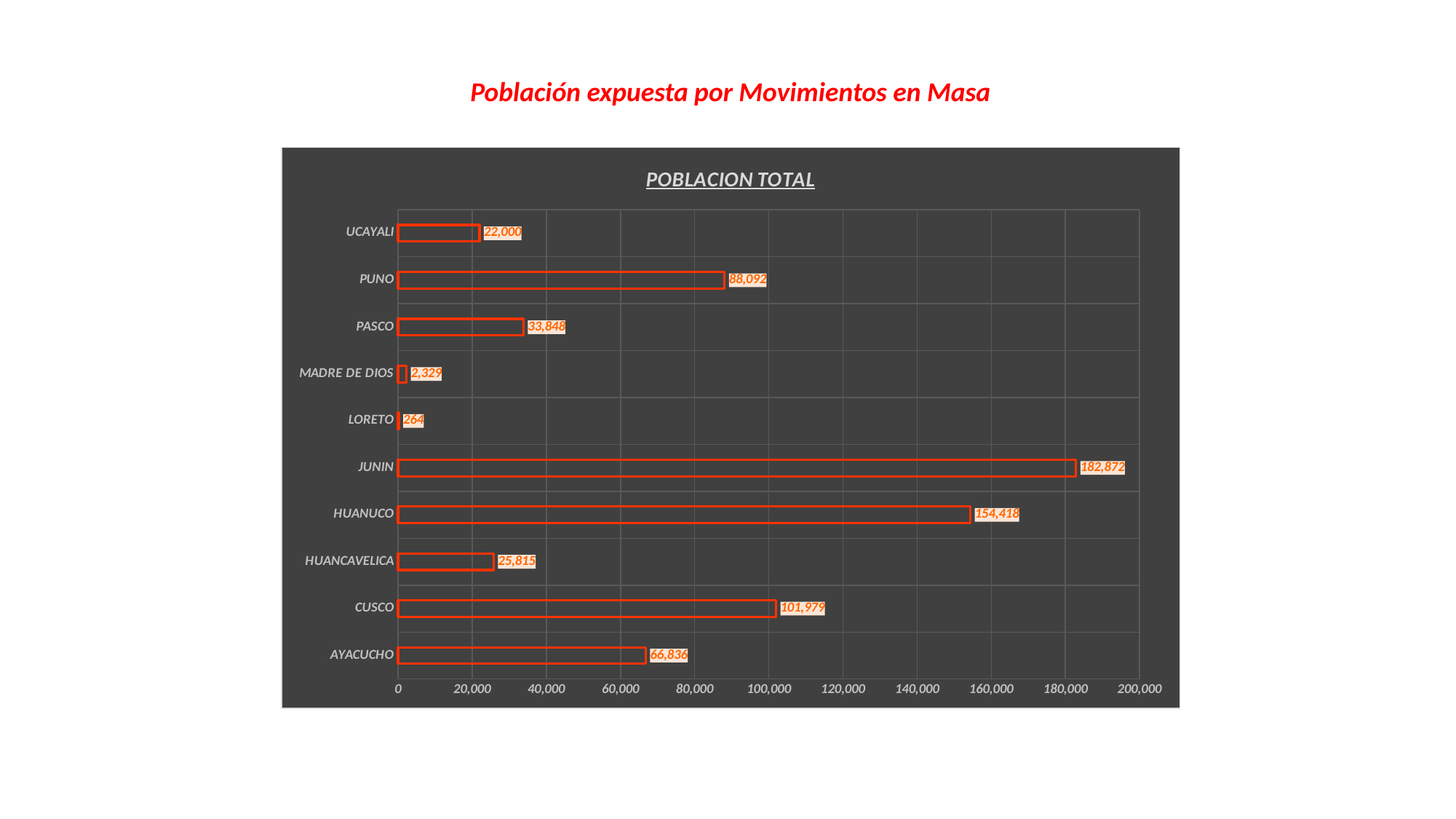
Which category has the highest value? JUNIN What is the difference between the values for PASCO and UCAYALI? 11,848 What is the title of the chart? POBLACION TOTAL Which is larger, the value for PUNO or the value for AYACUCHO? PUNO What is the difference between the values for JUNIN and HUANUCO? 28,454 What is the value for MADRE DE DIOS? 2,329 What kind of chart is shown? bar chart Is the value for HUANUCO greater or less than 140,000? greater Which category has the lowest value? LORETO What is the value for JUNIN? 182,872 How many categories are shown in the chart? 10 What is the value for CUSCO? 101,979